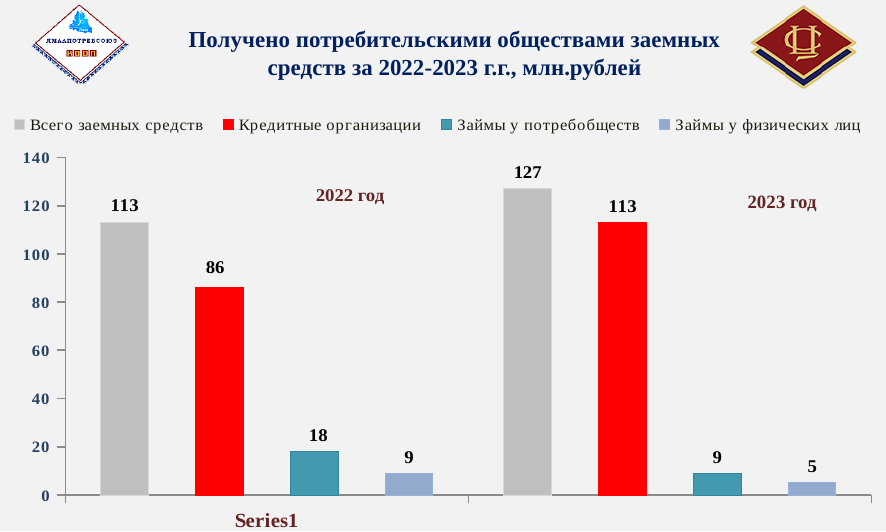
What is the difference between "Кредитные организации" in 2023 and in 2022? 27 What is the value for "Займы у потребобществ" in 2022? 18 Which series has the lowest value in 2022? Займы у физических лиц What is the value for "Займы у физических лиц" in 2023? 5 Which is larger: "Займы у потребобществ" in 2022 or in 2023? 2022 What colour are the bars for "Кредитные организации"? Red How many series does the legend list? 4 What is the value for "Кредитные организации" in 2023? 113 What is the difference between "Всего заемных средств" in 2023 and in 2022? 14 What is the value for "Всего заемных средств" in 2022? 113 Which series has the highest value in 2023? Всего заемных средств What kind of chart is shown on the slide? Bar chart